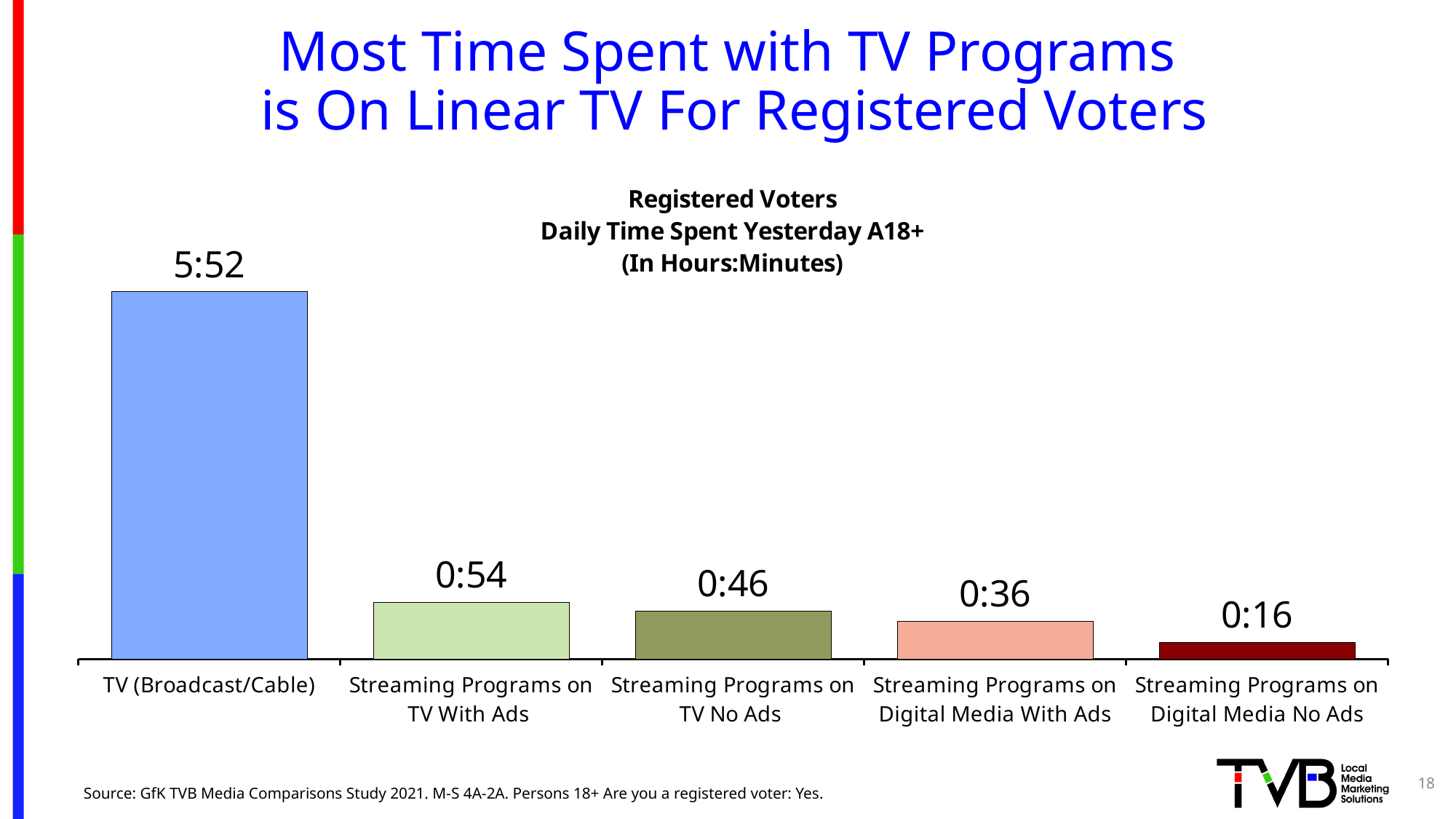
What kind of chart is shown on the slide? Bar chart Which has a larger daily time spent: Streaming Programs on TV No Ads or Streaming Programs on Digital Media With Ads? Streaming Programs on TV No Ads How many categories are shown in the chart? 5 In what units are the values in the chart expressed, according to the chart title? Hours:Minutes What is the difference in daily time spent between Streaming Programs on Digital Media With Ads and Streaming Programs on Digital Media No Ads? 0:20 What is the daily time spent for Streaming Programs on Digital Media With Ads? 0:36 What is the difference in daily time spent between Streaming Programs on TV With Ads and Streaming Programs on TV No Ads? 0:08 Which category has the highest daily time spent? TV (Broadcast/Cable) What is the daily time spent for TV (Broadcast/Cable)? 5:52 What is the daily time spent for Streaming Programs on TV With Ads? 0:54 What is the daily time spent for Streaming Programs on Digital Media No Ads? 0:16 Which category has the lowest daily time spent? Streaming Programs on Digital Media No Ads